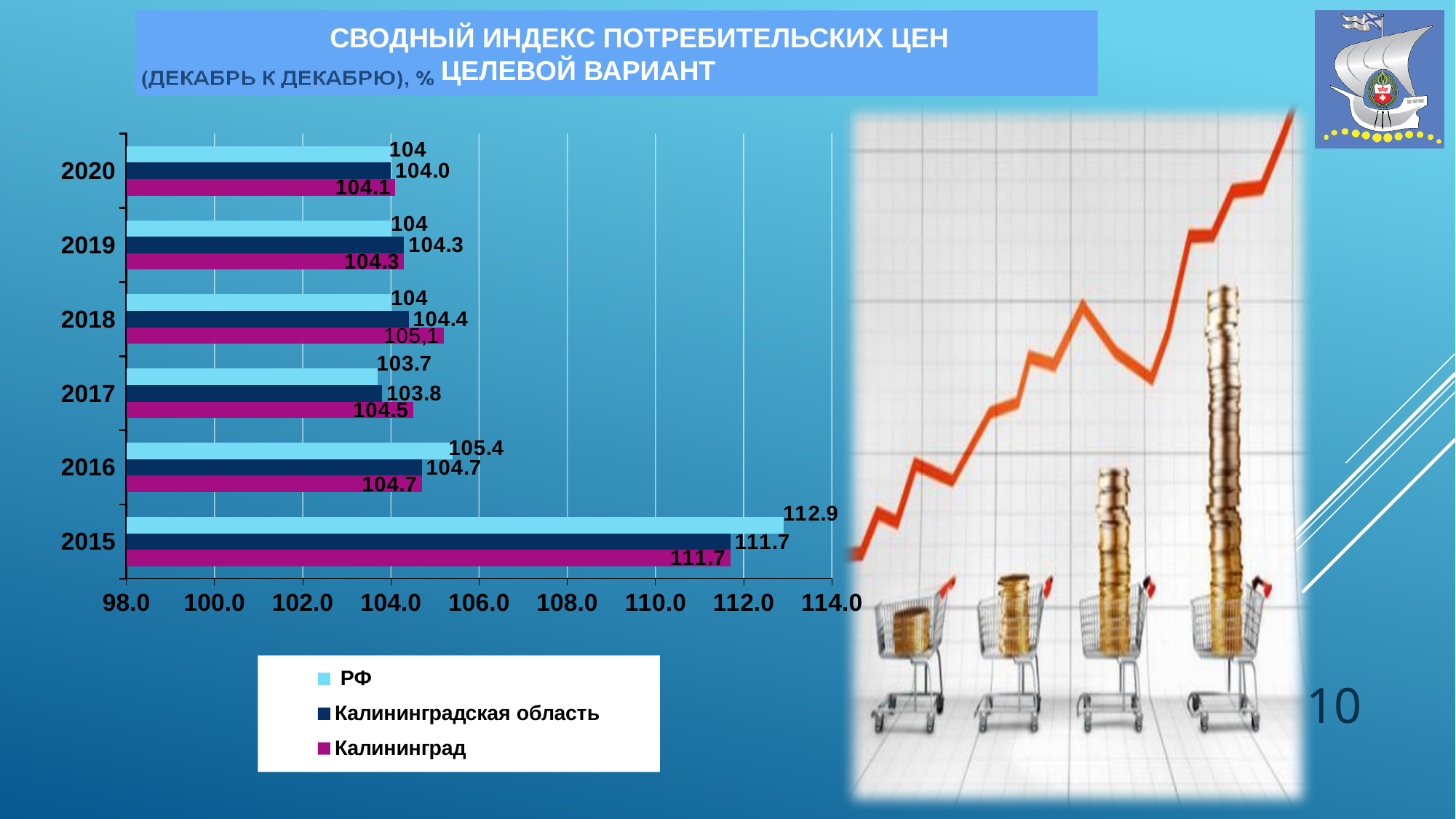
In which year is the value for РФ the highest? 2015 What is the value for Калининград in 2020? 104.1 In which year is the value for РФ the lowest? 2017 What kind of chart is shown on the slide? bar chart What is the value for Калининградская область in 2017? 103.8 How many years are shown on the chart? 6 In 2017, which is larger: the value for РФ or the value for Калининград? Калининград What is the difference between the РФ value and the Калининград value in 2016? 0.7 What is the value for РФ in 2015? 112.9 What is the difference between the РФ value and the Калининградская область value in 2015? 1.2 What is the value for Калининград in 2018? 105,1 How many series does the legend list? 3